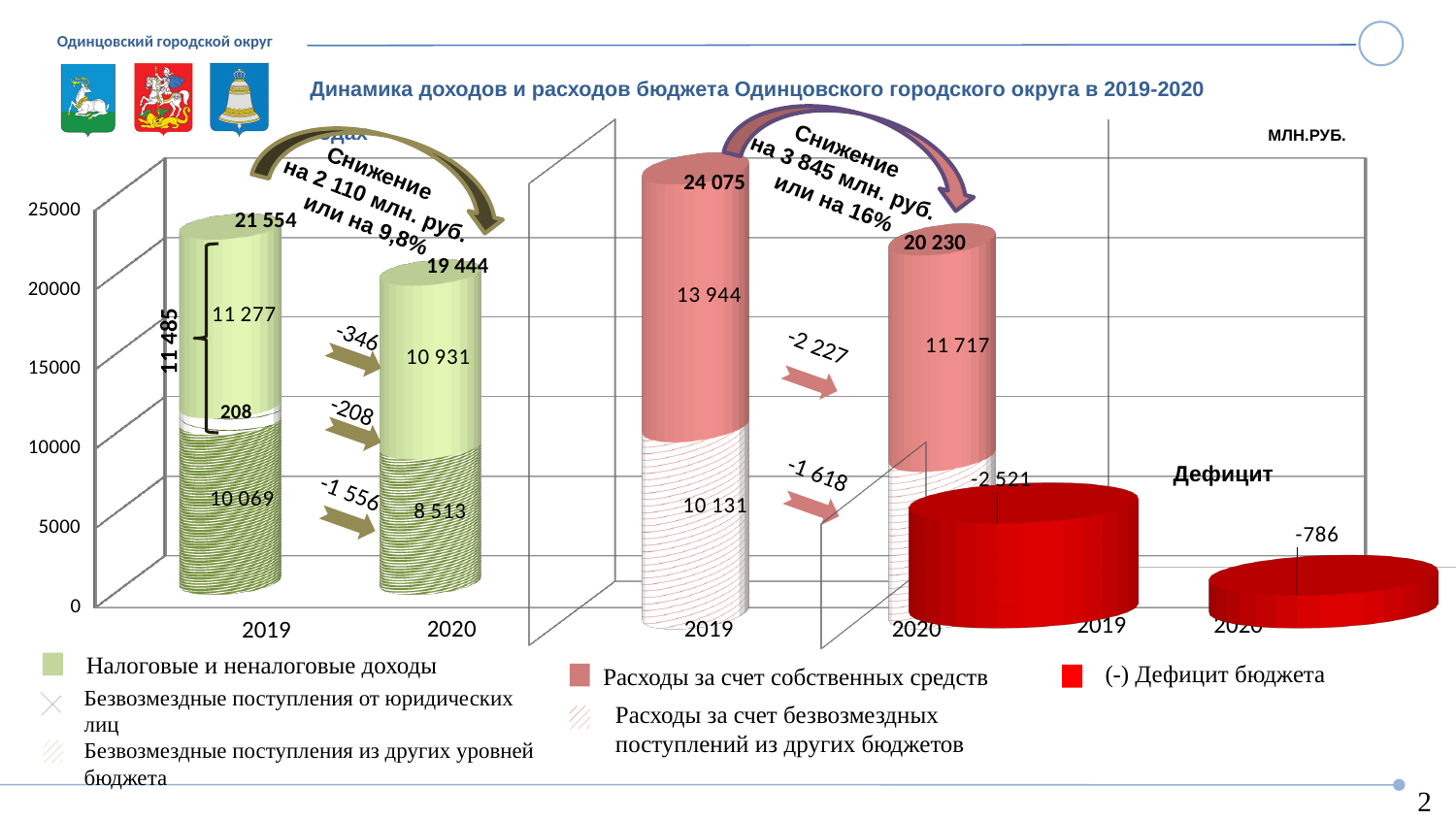
On the income chart (left, green bars), by how much did total income fall from 2019 to 2020? 2 110 On the 'Дефицит' chart (right, red), what is the budget deficit for 2019? -2 521 On the income chart (left, green bars), what is the total budget income for 2020? 19 444 On the expenses chart (middle, pink bars), what is the value of 'Расходы за счет собственных средств' in 2020? 11 717 On the expenses chart (middle, pink bars), which year has the larger total expenditure, 2019 or 2020? 2019 On the expenses chart (middle, pink bars), what is the total expenditure for 2019? 24 075 On the 'Дефицит' chart (right, red), what is the budget deficit for 2020? -786 On the income chart (left, green bars), what is the value of 'Налоговые и неналоговые доходы' in 2019? 11 277 On the income chart (left, green bars), what is the value of 'Безвозмездные поступления из других уровней бюджета' in 2020? 8 513 On the expenses chart (middle, pink bars), what is the difference between total expenditure in 2019 and 2020? 3 845 What kind of chart is used to show the income and expenses on this slide? Bar chart On the income chart (left, green bars), what is the total budget income for 2019? 21 554